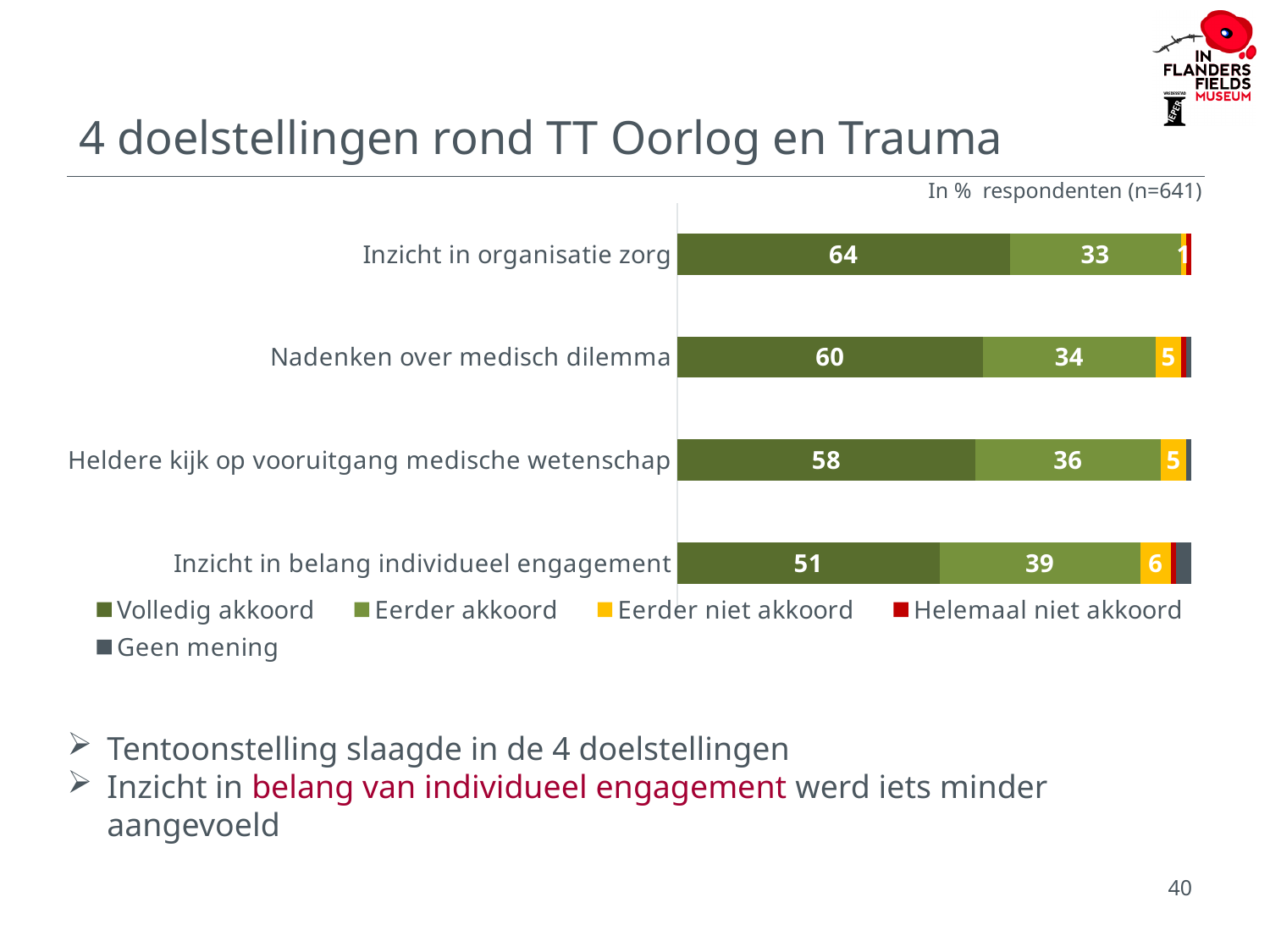
What is the 'Volledig akkoord' value for 'Nadenken over medisch dilemma'? 60 Which category has the lowest 'Volledig akkoord' value? Inzicht in belang individueel engagement What is the 'Volledig akkoord' value for 'Inzicht in organisatie zorg'? 64 Which category has the highest 'Volledig akkoord' value? Inzicht in organisatie zorg How many categories (doelstellingen) are plotted in the chart? 4 How many series does the legend list? 5 What is the 'Eerder akkoord' value for 'Heldere kijk op vooruitgang medische wetenschap'? 36 What is the unit and sample size noted above the chart? In % respondenten (n=641) Which is larger: the 'Eerder akkoord' value for 'Nadenken over medisch dilemma' or for 'Inzicht in belang individueel engagement'? Inzicht in belang individueel engagement What is the 'Eerder niet akkoord' value for 'Inzicht in belang individueel engagement'? 6 What is the difference between the 'Volledig akkoord' values for 'Inzicht in organisatie zorg' and 'Inzicht in belang individueel engagement'? 13 What kind of chart is shown on the slide? Stacked bar chart